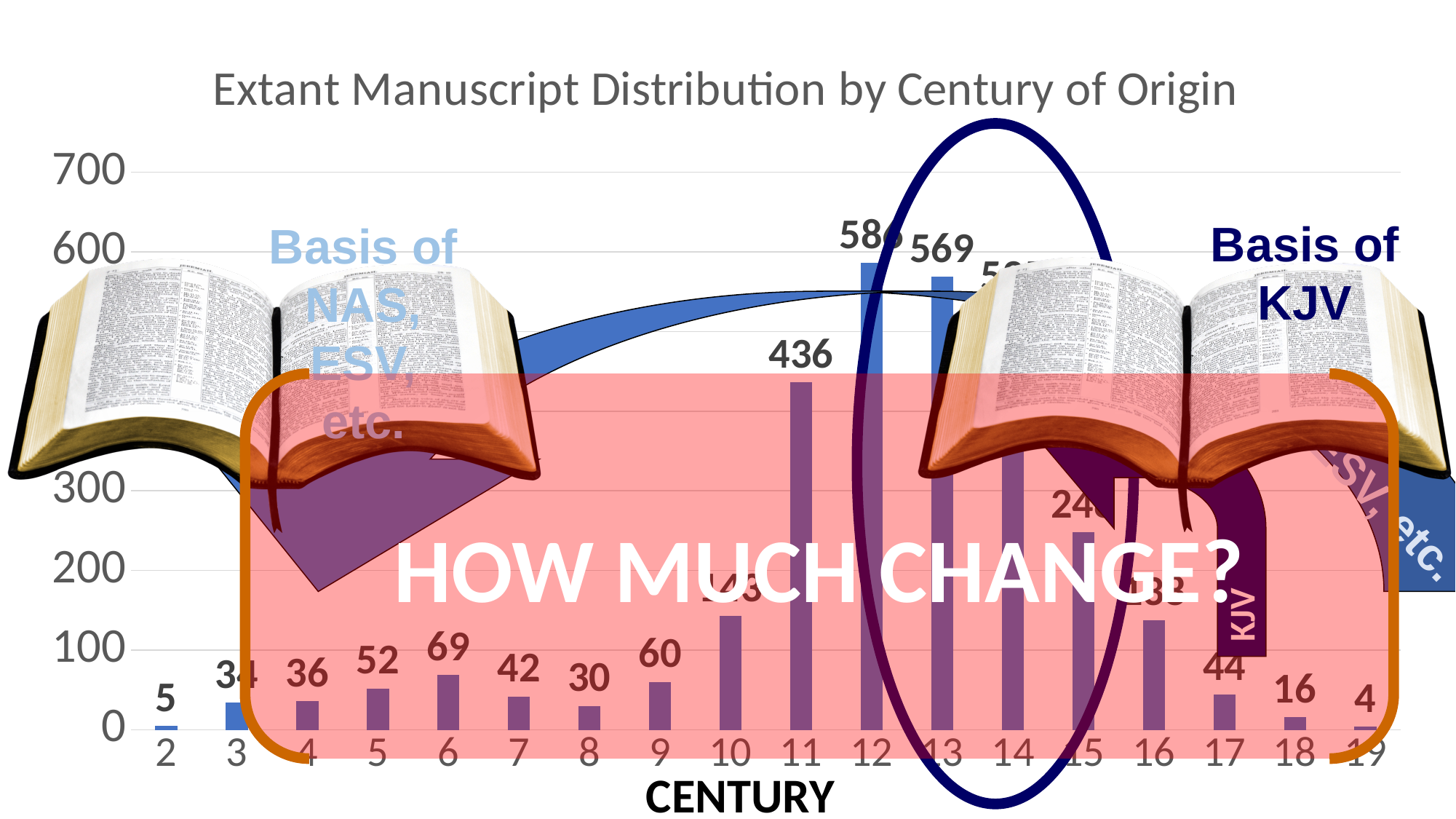
How many centuries are shown on the x axis? 18 What kind of chart is shown on the slide? bar chart What is the title of the chart? Extant Manuscript Distribution by Century of Origin Do the values rise or fall from century 16 to century 19? fall Which has a larger value, century 6 or century 9? century 6 What is the value for century 11? 436 What is the value for century 13? 569 Is the value for century 14 greater or less than 400? greater What is the difference between the values for century 17 and century 18? 28 What is the value for century 6? 69 What is the difference between the values for century 13 and century 11? 133 What is the value for century 18? 16